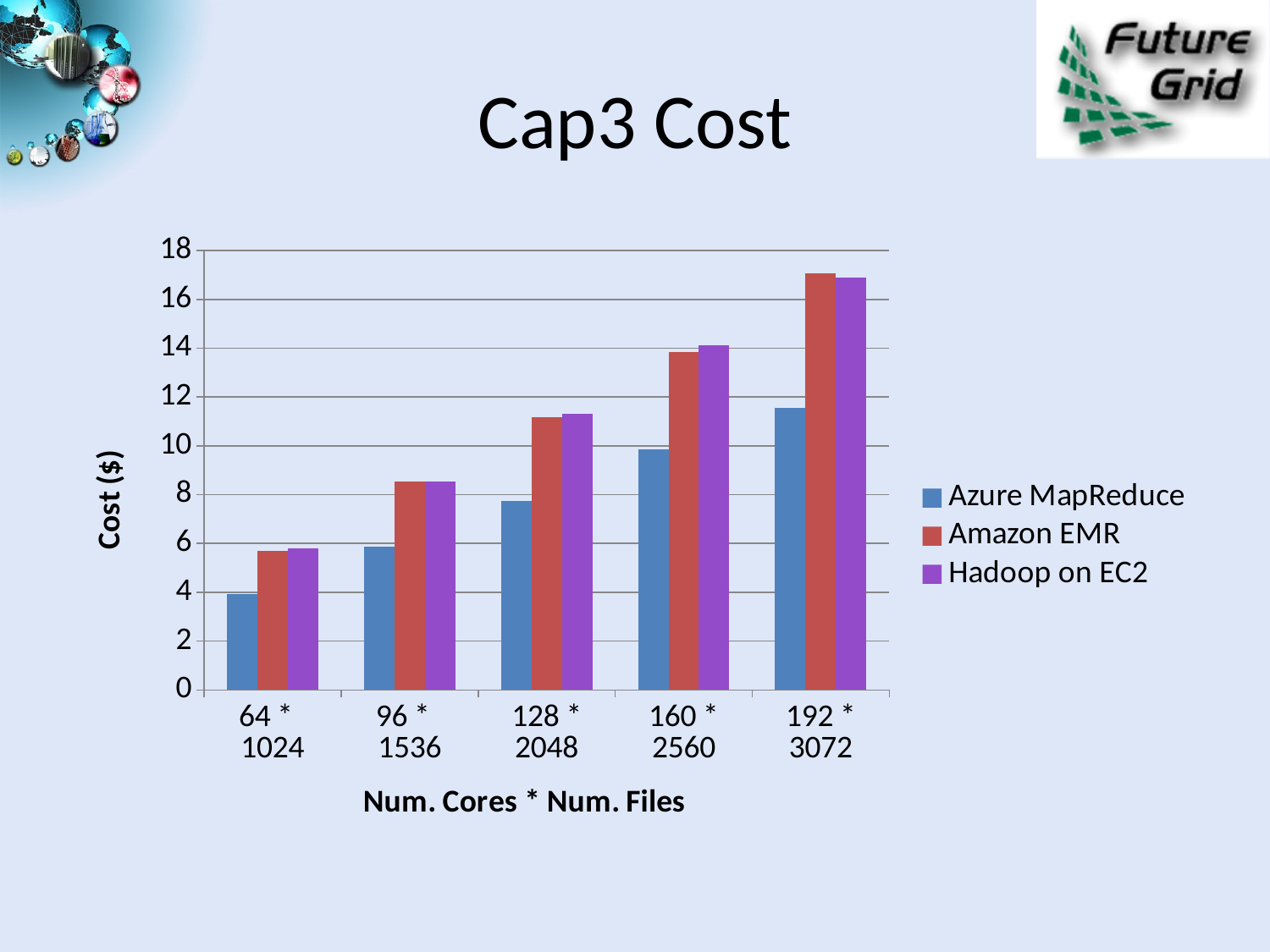
Is the Azure MapReduce value for 128 * 2048 greater or less than 8? less At 160 * 2560, which is larger: the Azure MapReduce cost or the Amazon EMR cost? Amazon EMR How many categories are shown on the x axis? 5 Is the Amazon EMR value for 128 * 2048 greater or less than 10? greater Is the Azure MapReduce value for 192 * 3072 greater or less than 12? less Do the Hadoop on EC2 costs rise or fall as Num. Cores * Num. Files increases along the x axis? rise For which category is the Azure MapReduce cost highest? 192 * 3072 For which category is the Amazon EMR cost lowest? 64 * 1024 What kind of chart is shown on the slide? bar chart How many series does the legend list? 3 What is the title of the y axis? Cost ($)